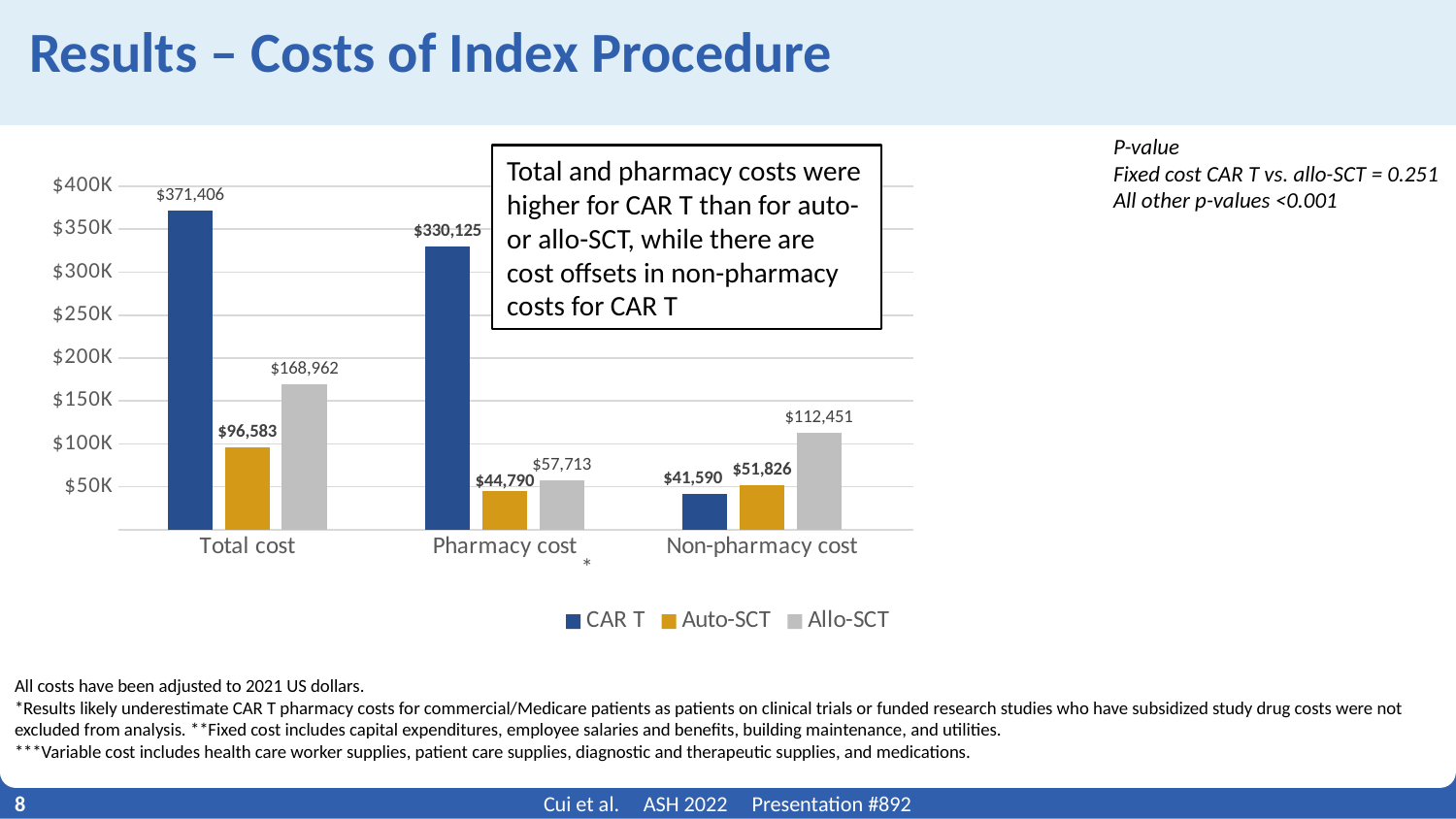
How many cost categories are shown on the x axis? 3 What kind of chart is shown on the slide? bar chart What is the Pharmacy cost for Auto-SCT? $44,790 Which series has the lowest Total cost? Auto-SCT What is the difference between the CAR T and Allo-SCT Total cost values? $202,444 What is the Total cost for CAR T? $371,406 How many series does the legend list? 3 What is the difference between the Allo-SCT and CAR T Non-pharmacy cost values? $70,861 Which series has the highest Non-pharmacy cost? Allo-SCT Which is larger, the Pharmacy cost for Allo-SCT or for Auto-SCT? Allo-SCT What is the Non-pharmacy cost for Allo-SCT? $112,451 Is the Pharmacy cost for CAR T greater or less than $300K? greater